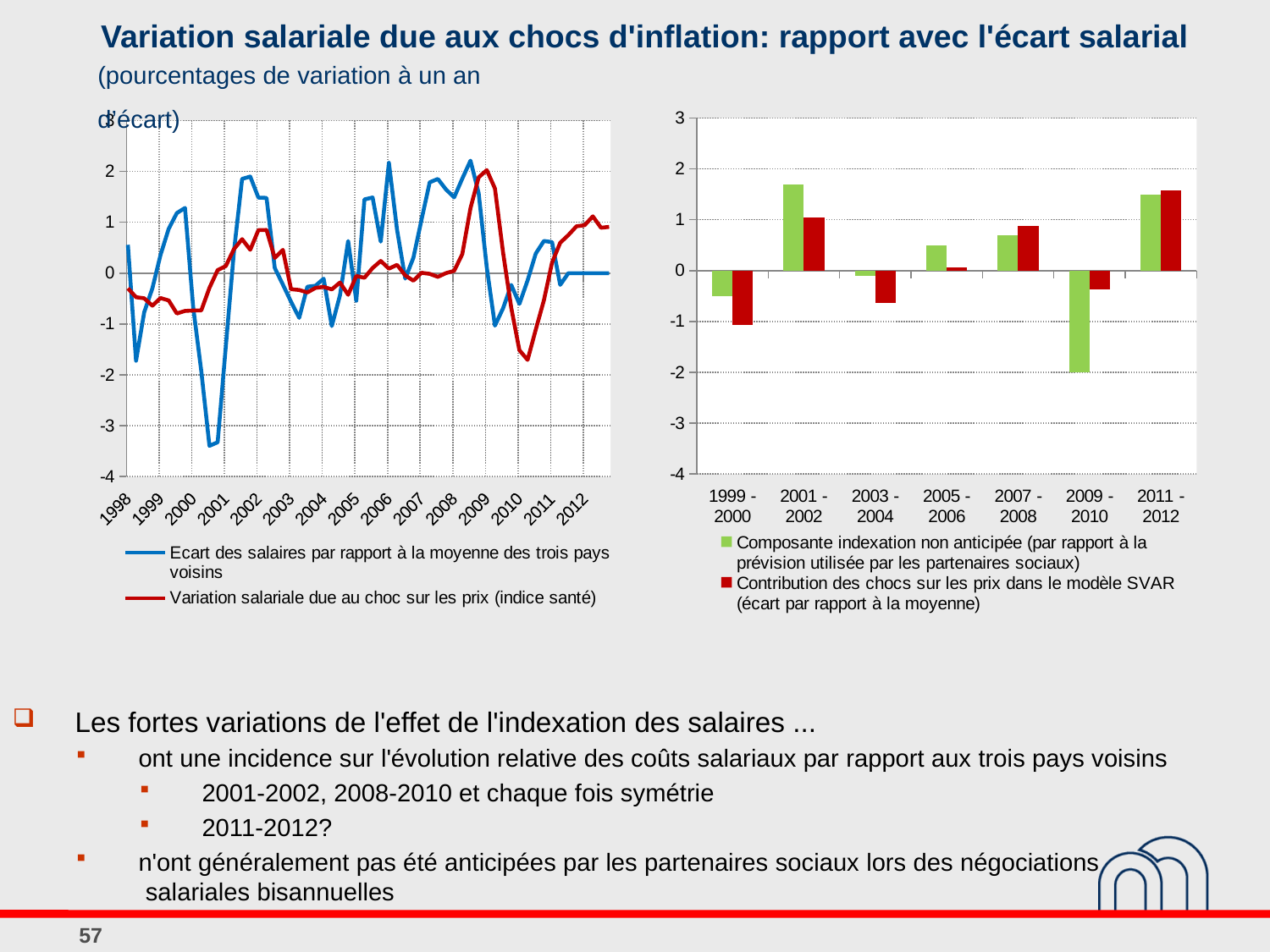
In the bar chart on the right, for 2001 - 2002, which series has the larger value: 'Composante indexation non anticipée' or 'Contribution des chocs sur les prix dans le modèle SVAR'? Composante indexation non anticipée In the bar chart on the right, is the value of 'Composante indexation non anticipée' for 2009 - 2010 greater or less than -1? less What type of chart is the chart on the left of the slide? line chart In the bar chart on the right, which period has the highest value for 'Contribution des chocs sur les prix dans le modèle SVAR'? 2011 - 2012 In the bar chart on the right, how many period categories are shown on the x axis? 7 In the bar chart on the right, how many series does the legend list? 2 In the bar chart on the right, which period has the lowest value for 'Contribution des chocs sur les prix dans le modèle SVAR'? 1999 - 2000 In the bar chart on the right, is the value of 'Composante indexation non anticipée' for 2001 - 2002 greater or less than 1? greater In the line chart on the left, in which year does the 'Ecart des salaires par rapport à la moyenne des trois pays voisins' line reach its lowest point? 2000 In the bar chart on the right, which period has the lowest value for 'Composante indexation non anticipée'? 2009 - 2010 What type of chart is the chart on the right of the slide? bar chart In the line chart on the left, how many series does the legend list? 2